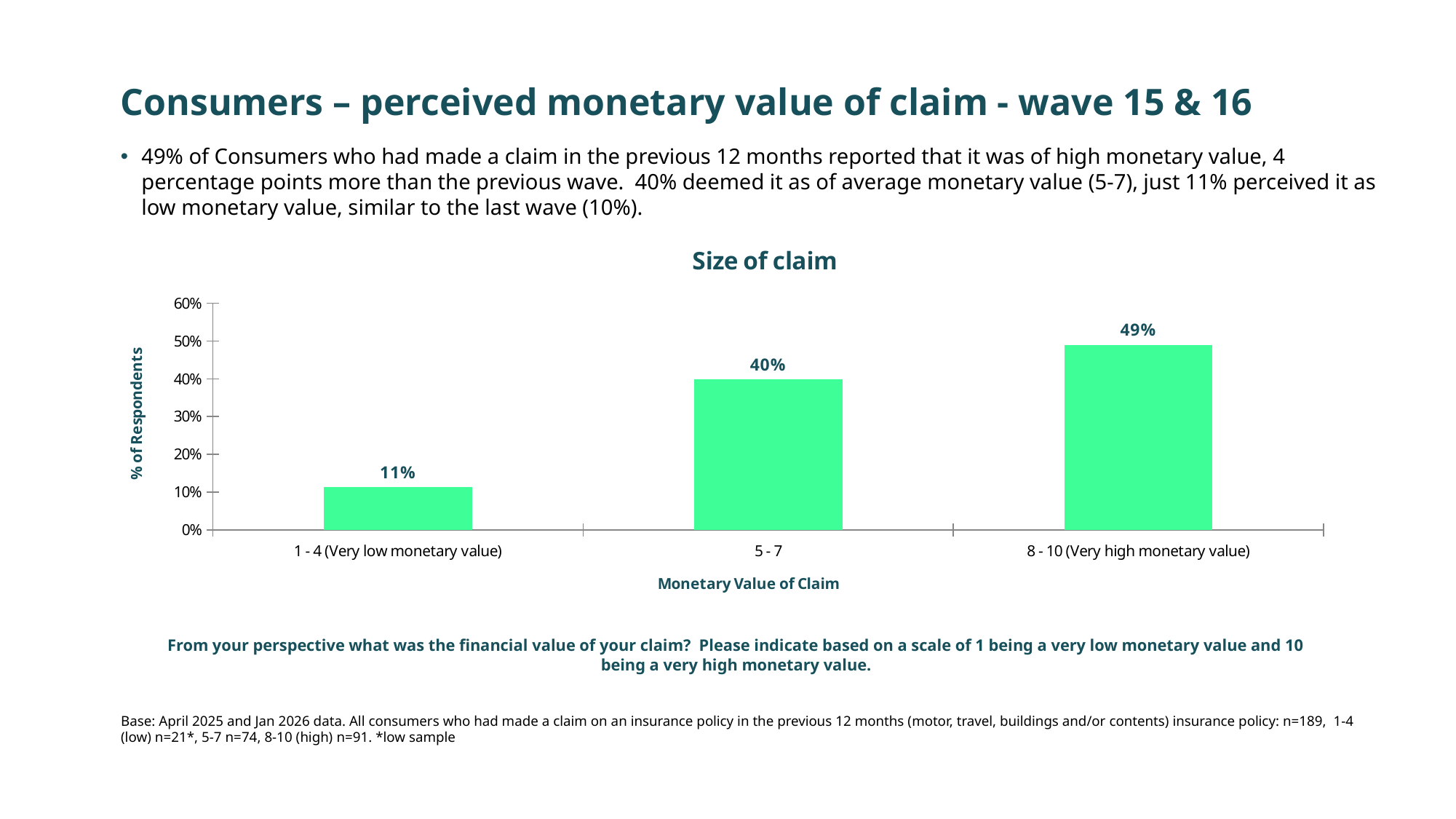
Do the values rise or fall moving from the lowest to the highest monetary value category along the x axis? Rise What is the difference in percentage points between the 8 - 10 (Very high monetary value) and 5 - 7 categories? 9 percentage points What type of chart is used to show the size of claim? Bar chart Which monetary value category has the lowest percentage of respondents? 1 - 4 (Very low monetary value) Which monetary value category has the highest percentage of respondents? 8 - 10 (Very high monetary value) What percentage of respondents rated their claim as 1 - 4 (Very low monetary value)? 11% Which category has a larger share of respondents: 5 - 7 or 1 - 4 (Very low monetary value)? 5 - 7 How many monetary value categories are shown on the chart? 3 Is the value for 5 - 7 greater or less than 30%? greater What percentage of respondents rated their claim as 5 - 7? 40% What is the difference in percentage points between the 8 - 10 (Very high monetary value) and 1 - 4 (Very low monetary value) categories? 38 percentage points What percentage of respondents rated their claim as 8 - 10 (Very high monetary value)? 49%